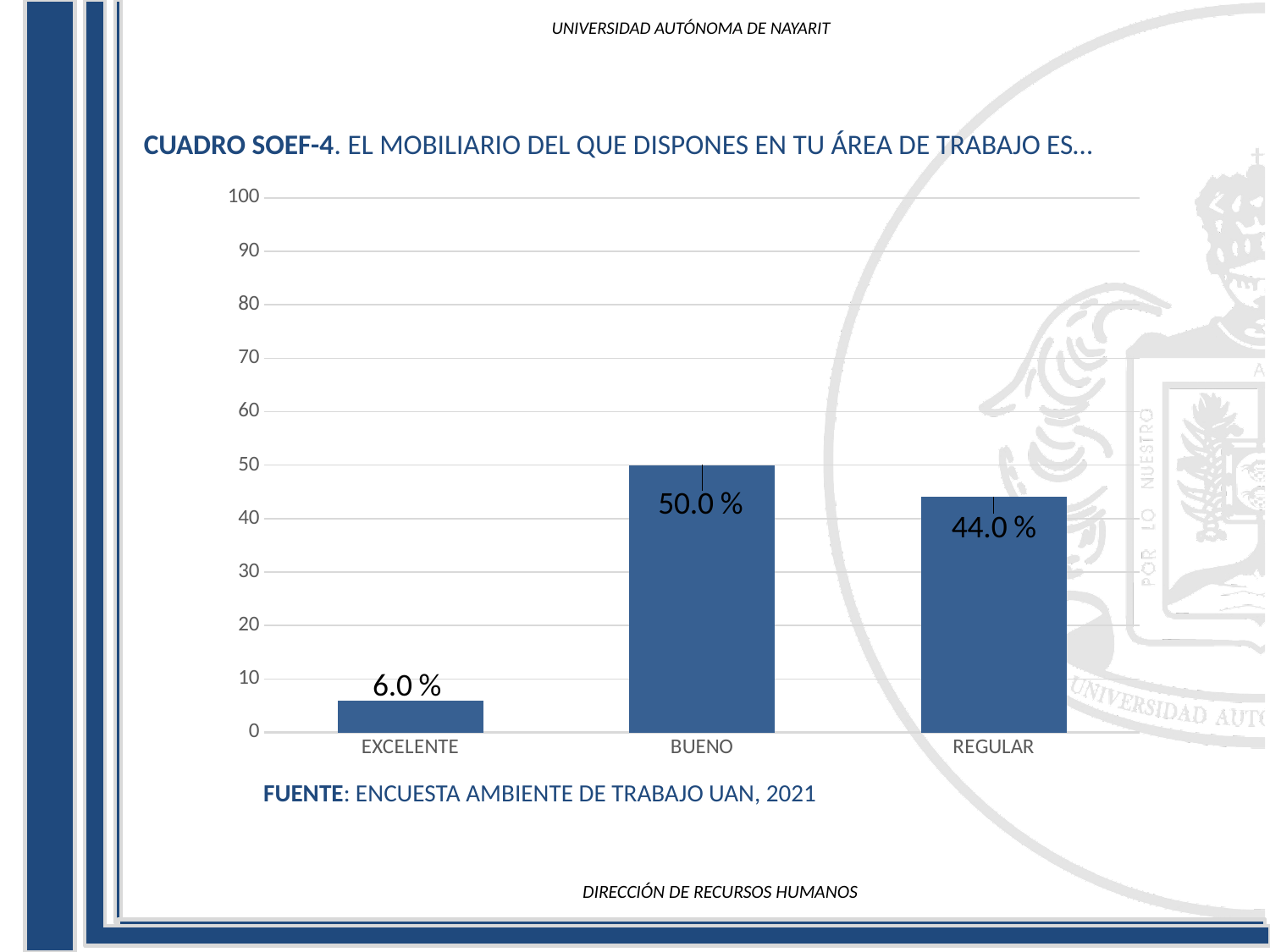
What is the value for BUENO? 50.0 % Which is larger, the value for REGULAR or the value for EXCELENTE? REGULAR What is the difference between the values for BUENO and REGULAR? 6.0 % Which category has the lowest value? EXCELENTE Which category has the highest value? BUENO What is the difference between the values for REGULAR and EXCELENTE? 38.0 % What is the value for REGULAR? 44.0 % How many categories are shown on the x axis? 3 Is the value for REGULAR greater or less than 40? greater What kind of chart is shown on the slide? bar chart What is the source cited below the chart? ENCUESTA AMBIENTE DE TRABAJO UAN, 2021 What is the value for EXCELENTE? 6.0 %